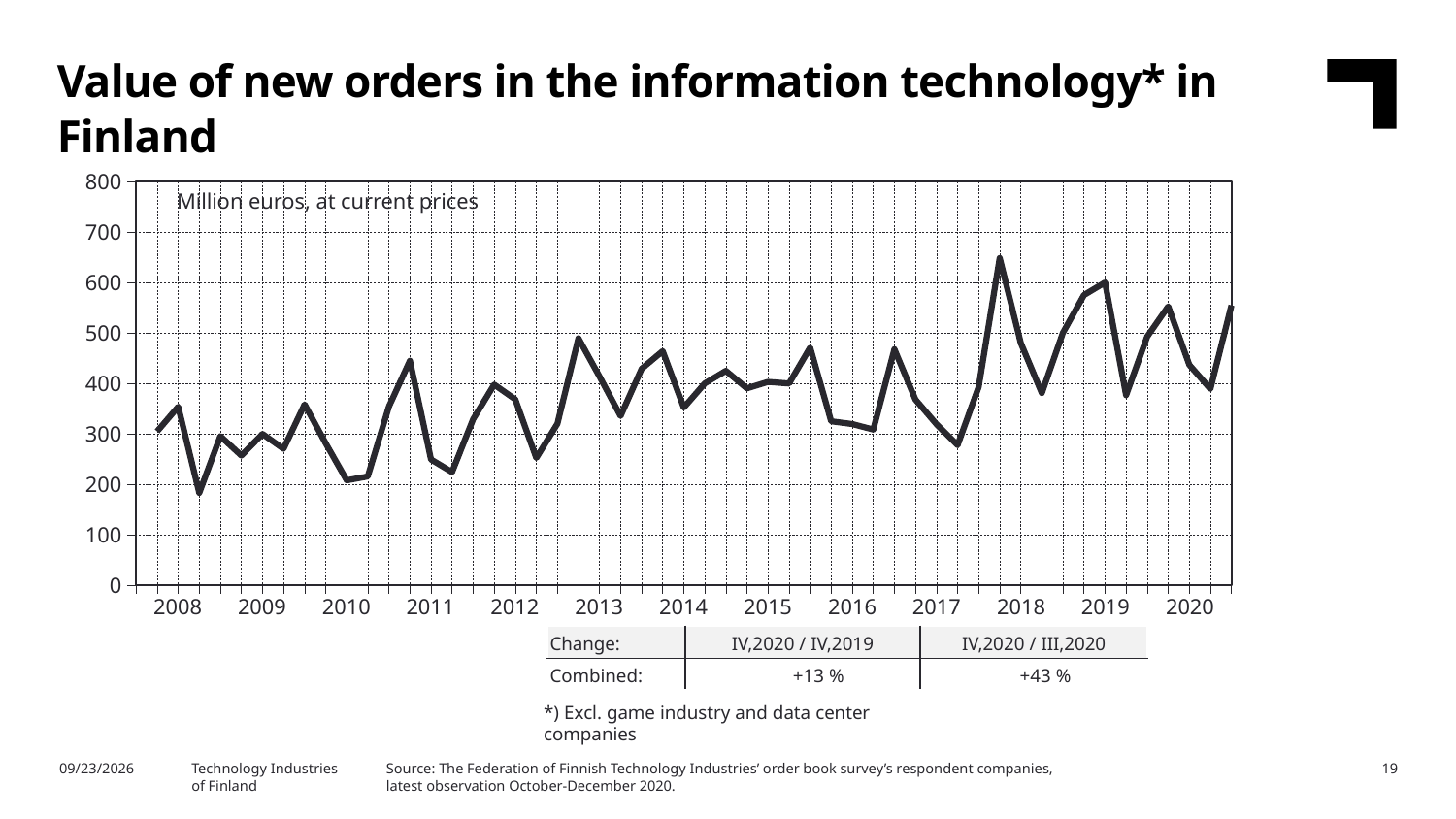
Does the line rise or fall between the third and fourth quarters of 2020? rise What unit is the value of new orders measured in, according to the label inside the chart? Million euros, at current prices How many years are labeled on the x axis of the chart? 13 In which year does the line reach its highest point? 2018 What type of chart is shown on the slide? line chart Is the final value plotted at the end of 2020 greater or less than 500? greater Is the lowest value reached in 2008 greater or less than 250? less Is the highest value reached in 2018 greater or less than 600? greater What is the title of the chart on the slide? Value of new orders in the information technology* in Finland According to the table below the chart, what is the combined change for IV,2020 / IV,2019? +13 % According to the table below the chart, what is the combined change for IV,2020 / III,2020? +43 %